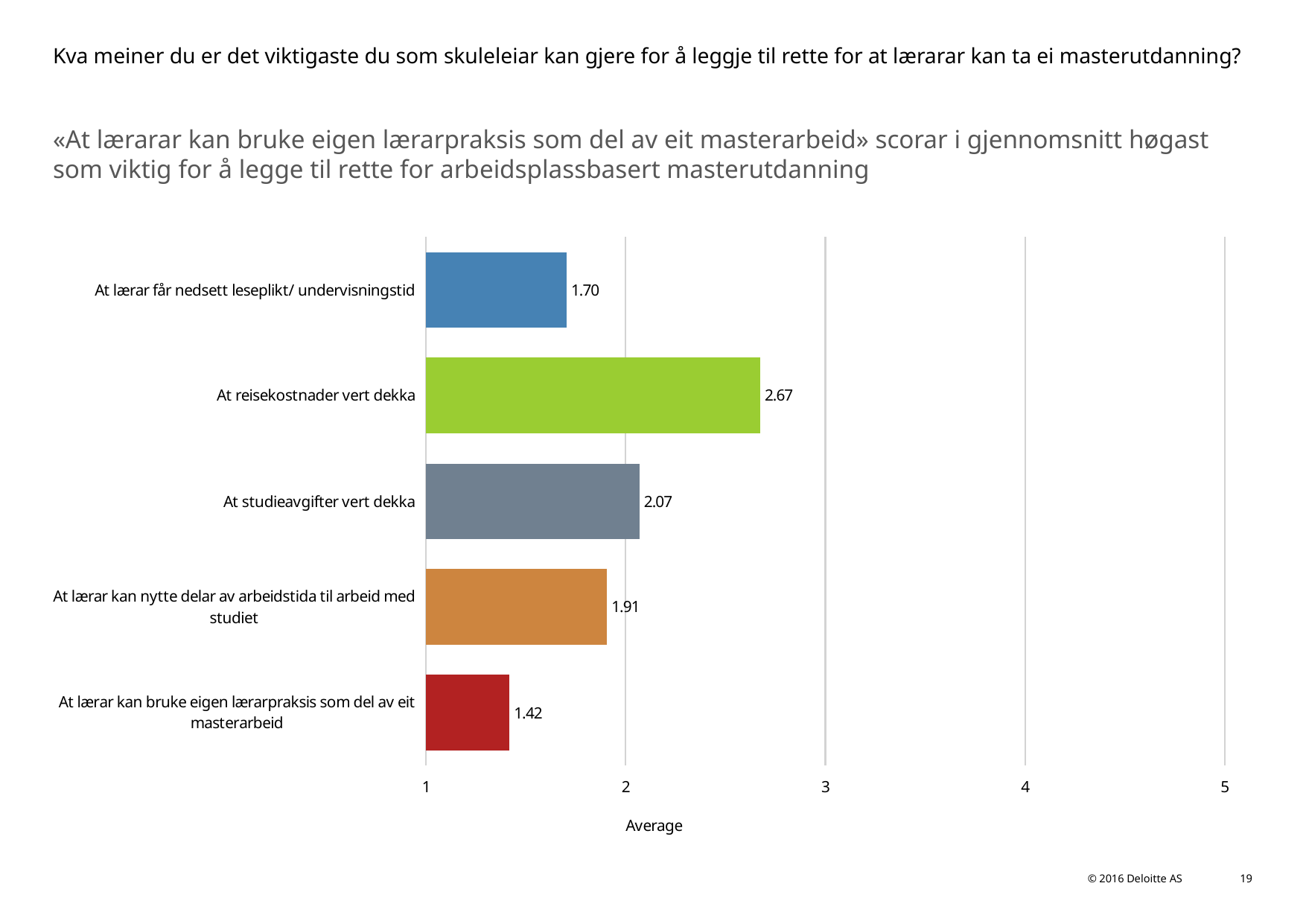
What is the difference between the average values for "At reisekostnader vert dekka" and "At studieavgifter vert dekka"? 0.60 What is the average value for "At reisekostnader vert dekka"? 2.67 What kind of chart is shown on the slide? Bar chart Which category has the lowest average value? At lærar kan bruke eigen lærarpraksis som del av eit masterarbeid What is the label of the horizontal axis? Average Which has a higher average value: "At lærar kan nytte delar av arbeidstida til arbeid med studiet" or "At lærar får nedsett leseplikt/ undervisningstid"? At lærar kan nytte delar av arbeidstida til arbeid med studiet Is the value for "At studieavgifter vert dekka" greater or less than 2? greater What is the average value for "At lærar kan bruke eigen lærarpraksis som del av eit masterarbeid"? 1.42 What is the average value for "At lærar får nedsett leseplikt/ undervisningstid"? 1.70 What is the average value for "At studieavgifter vert dekka"? 2.07 How many categories are shown in the chart? 5 Which category has the highest average value? At reisekostnader vert dekka